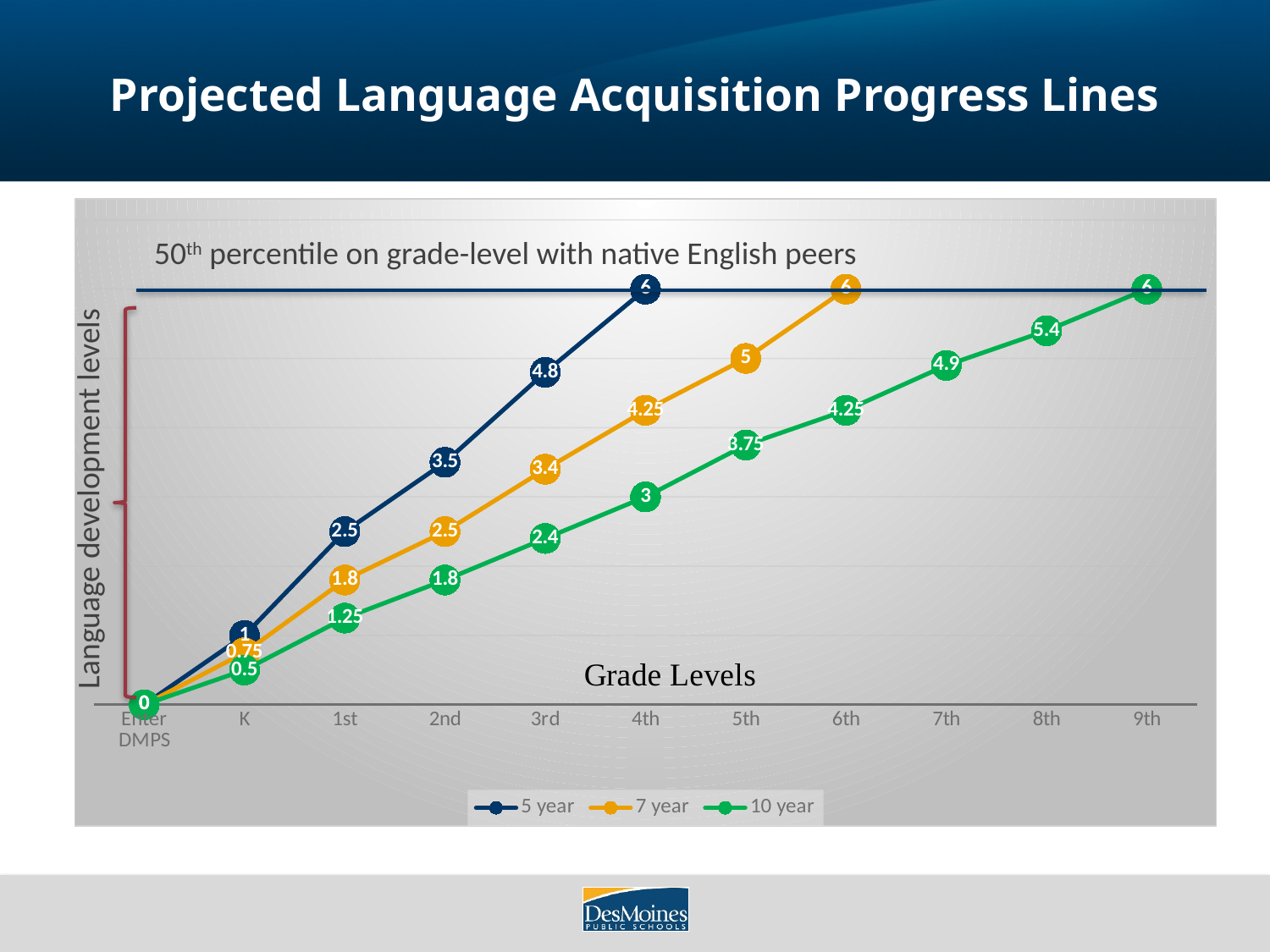
Do the values of the 10 year series rise or fall from Enter DMPS to 9th grade? Rise What is the difference between the 7 year and 10 year values at 4th grade? 1.25 What is the value of the 7 year series at K? 0.75 What is the value of the 10 year series at 8th grade? 5.4 What is the value of the 5 year series at 3rd grade? 4.8 What is the value of the 7 year series at 5th grade? 5 What is the title of the x axis? Grade Levels How many series does the legend list? 3 What kind of chart is shown on the slide? Line chart At 1st grade, which series has the larger value, 5 year or 10 year? 5 year What is the difference between the 5 year and 7 year values at 2nd grade? 1 Which series has the highest value at 3rd grade? 5 year